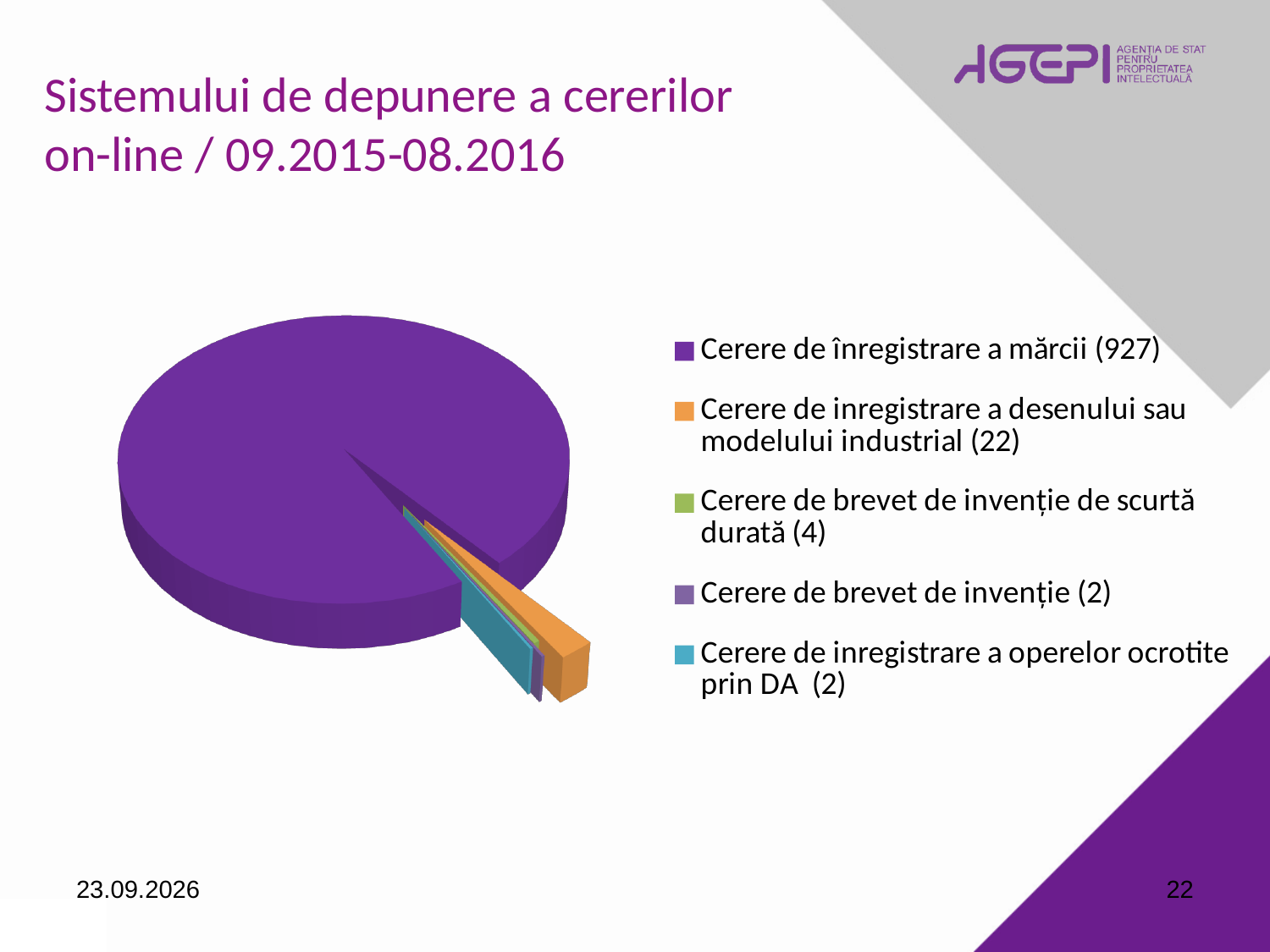
What period does the slide title say the data covers? 09.2015-08.2016 What is the value for "Cerere de brevet de invenție de scurtă durată"? 4 What is the difference between the values for "Cerere de înregistrare a mărcii" and "Cerere de inregistrare a desenului sau modelului industrial"? 905 How many categories does the pie chart show? 5 What is the value for "Cerere de brevet de invenție"? 2 Which category has the largest slice of the pie? Cerere de înregistrare a mărcii What is the value for "Cerere de inregistrare a operelor ocrotite prin DA"? 2 What type of chart is shown on the slide? pie chart What is the value for "Cerere de inregistrare a desenului sau modelului industrial"? 22 What colour is the largest slice of the pie chart? purple Which is larger: the value for "Cerere de inregistrare a desenului sau modelului industrial" or for "Cerere de brevet de invenție de scurtă durată"? Cerere de inregistrare a desenului sau modelului industrial What is the value for "Cerere de înregistrare a mărcii"? 927